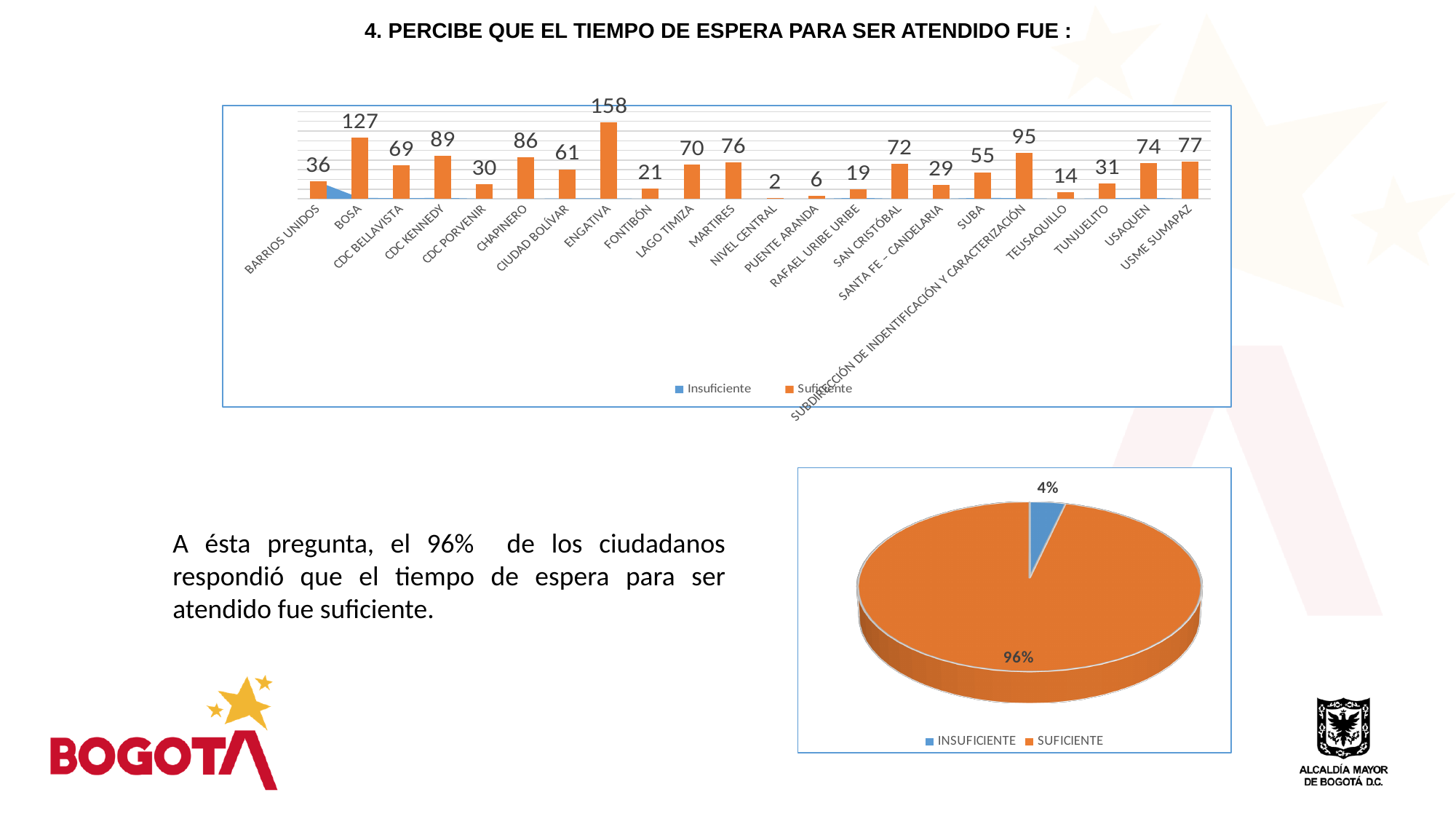
In the top bar chart, what is the Suficiente value for ENGATIVA? 158 In the top bar chart, which category has the lowest Suficiente value? NIVEL CENTRAL In the pie chart at the bottom right, what share does SUFICIENTE have? 96% In the top bar chart, what is the Suficiente value for TEUSAQUILLO? 14 How many series does the legend of the top bar chart list? 2 How many categories are shown on the x axis of the top bar chart? 22 In the top bar chart, which has a larger Suficiente value, CDC KENNEDY or CHAPINERO? CDC KENNEDY In the top bar chart, which category has the highest Suficiente value? ENGATIVA In the pie chart at the bottom right, what share does INSUFICIENTE have? 4% What kind of chart is the chart at the top of the slide? Bar chart In the top bar chart, what is the Suficiente value for BOSA? 127 In the top bar chart, what is the difference between the Suficiente values for ENGATIVA and BOSA? 31